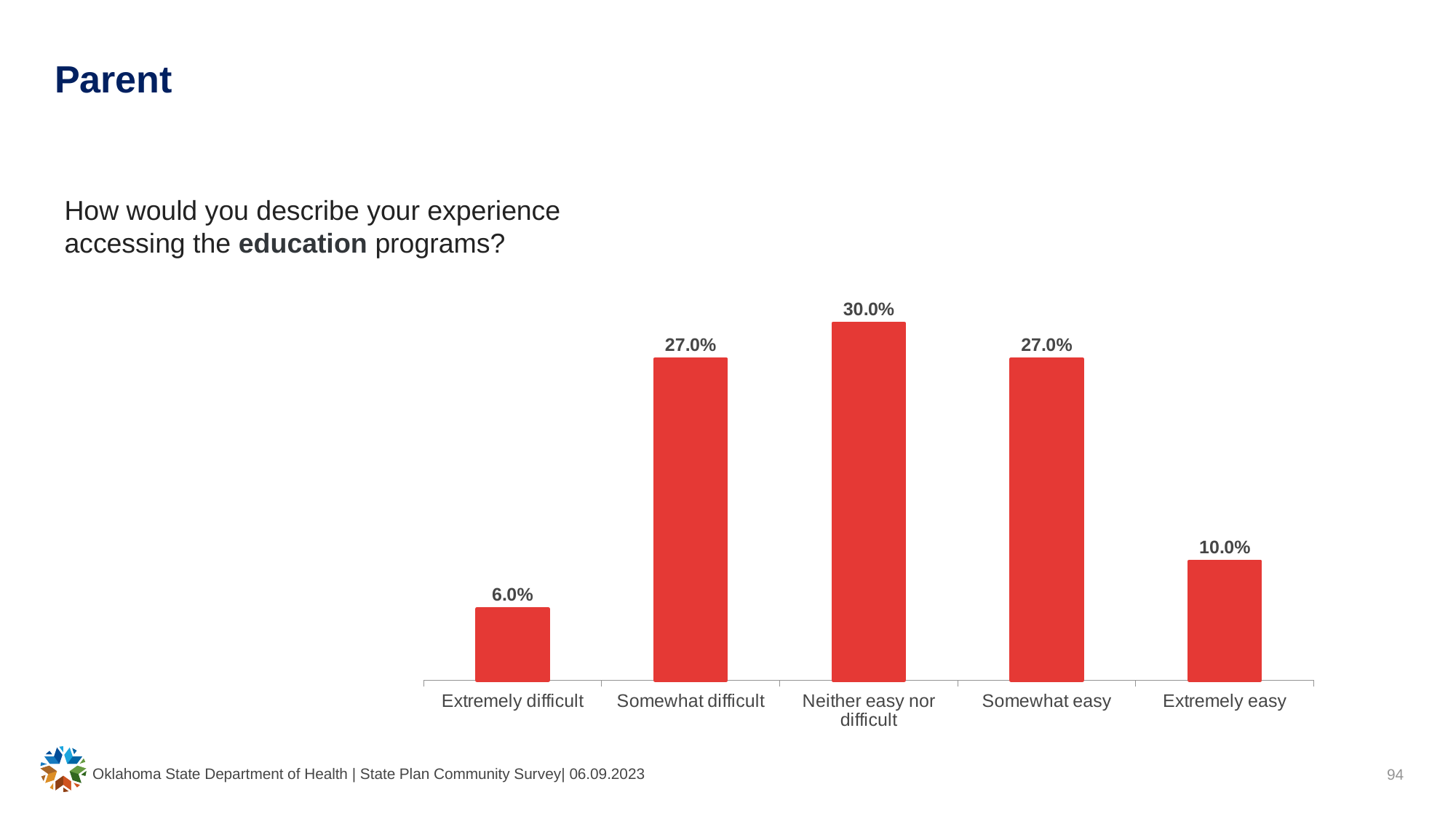
What kind of chart is shown on the slide? Bar chart What is the difference between the values for "Neither easy nor difficult" and "Extremely easy"? 20.0% What is the value for "Somewhat easy"? 27.0% What is the value shown for "Neither easy nor difficult"? 30.0% Which category has the highest value? Neither easy nor difficult How many categories are shown on the x axis? 5 Which category has the lowest value? Extremely difficult What is the difference between the values for "Extremely easy" and "Extremely difficult"? 4.0% Which is larger, the value for "Somewhat difficult" or the value for "Extremely easy"? Somewhat difficult What percentage of parents described accessing the education programs as "Extremely difficult"? 6.0% What percentage is shown for "Extremely easy"? 10.0% What colour are the bars in the chart? Red